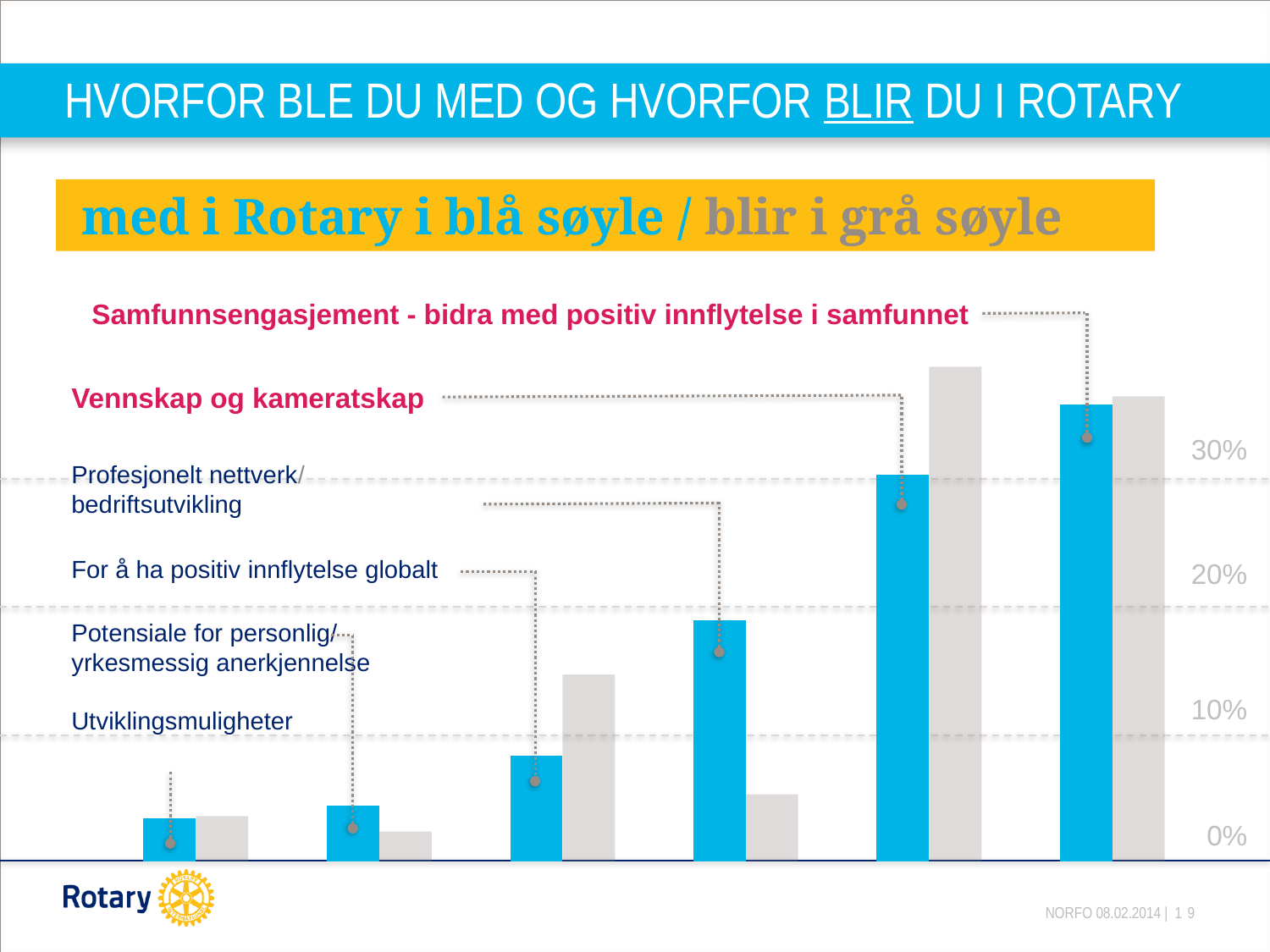
Which category has the highest grey bar? Vennskap og kameratskap For Profesjonelt nettverk/bedriftsutvikling, which bar is larger, the blue or the grey? blue Is the blue bar for Vennskap og kameratskap greater or less than 20%? greater Is the blue bar for Samfunnsengasjement greater or less than 30%? greater For 'For å ha positiv innflytelse globalt', which bar is larger, the blue or the grey? grey What kind of chart is shown on the slide? bar chart How many categories (reasons) are plotted in the chart? 6 Is the grey bar for Vennskap og kameratskap greater or less than 30%? greater According to the yellow banner, what does the blue bar represent? med i Rotary How many series does the chart show (blue and grey bars)? 2 Which category has the highest blue bar? Samfunnsengasjement - bidra med positiv innflytelse i samfunnet